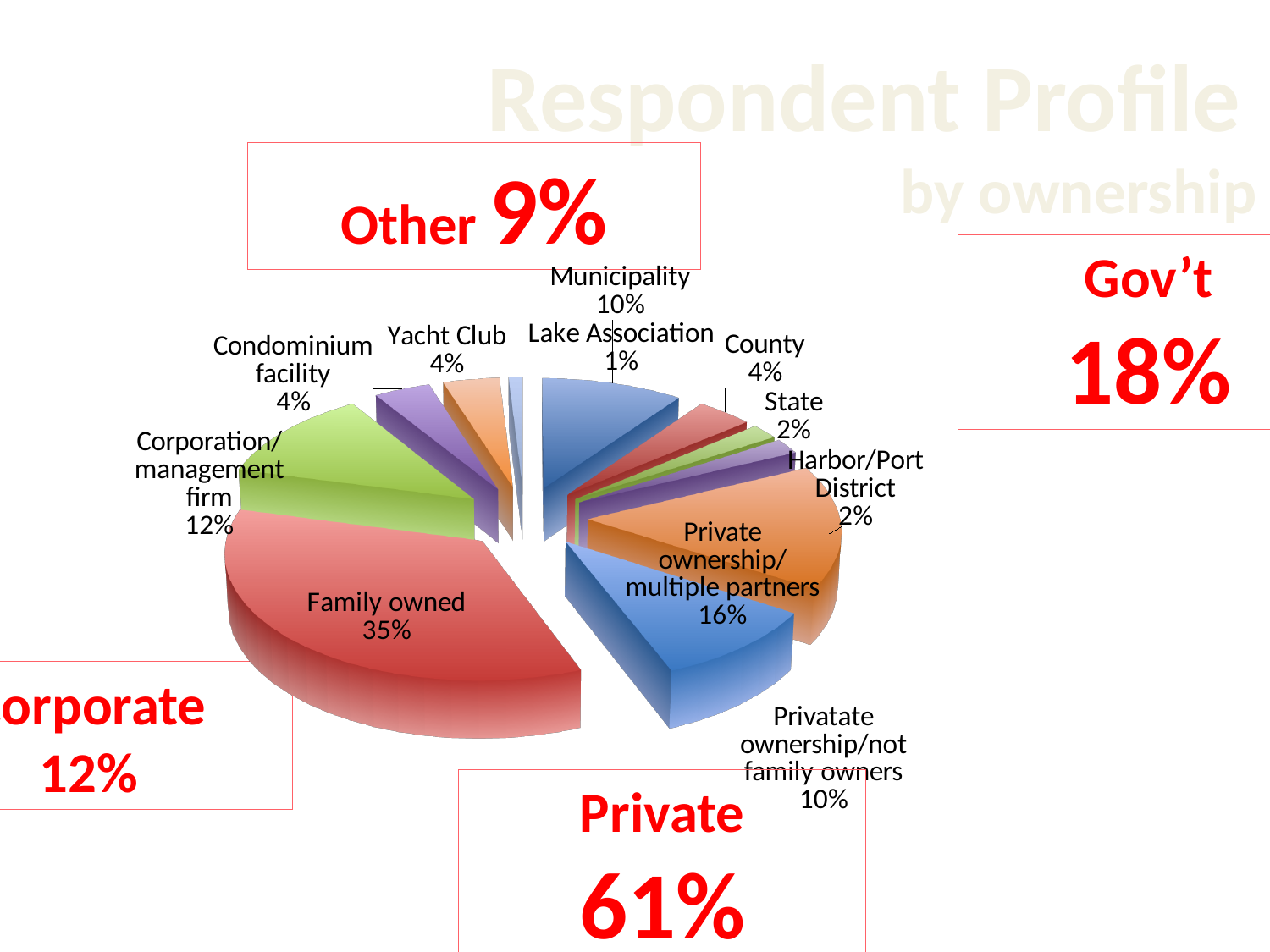
What kind of chart is shown on the slide? pie chart What percentage does the slide give for the Private group? 61% What is the difference in percentage points between Family owned and Private ownership/multiple partners? 19 Which is larger, the Municipality slice or the County slice? Municipality Which category has the smallest slice of the pie? Lake Association What share of respondents are Corporation/management firm? 12% What share of respondents are Family owned? 35% What percentage does the slide give for the Gov't group? 18% What share of respondents are Private ownership/multiple partners? 16% Which category has the largest slice of the pie? Family owned How many categories are shown in the pie chart? 11 What share of respondents are Municipality? 10%